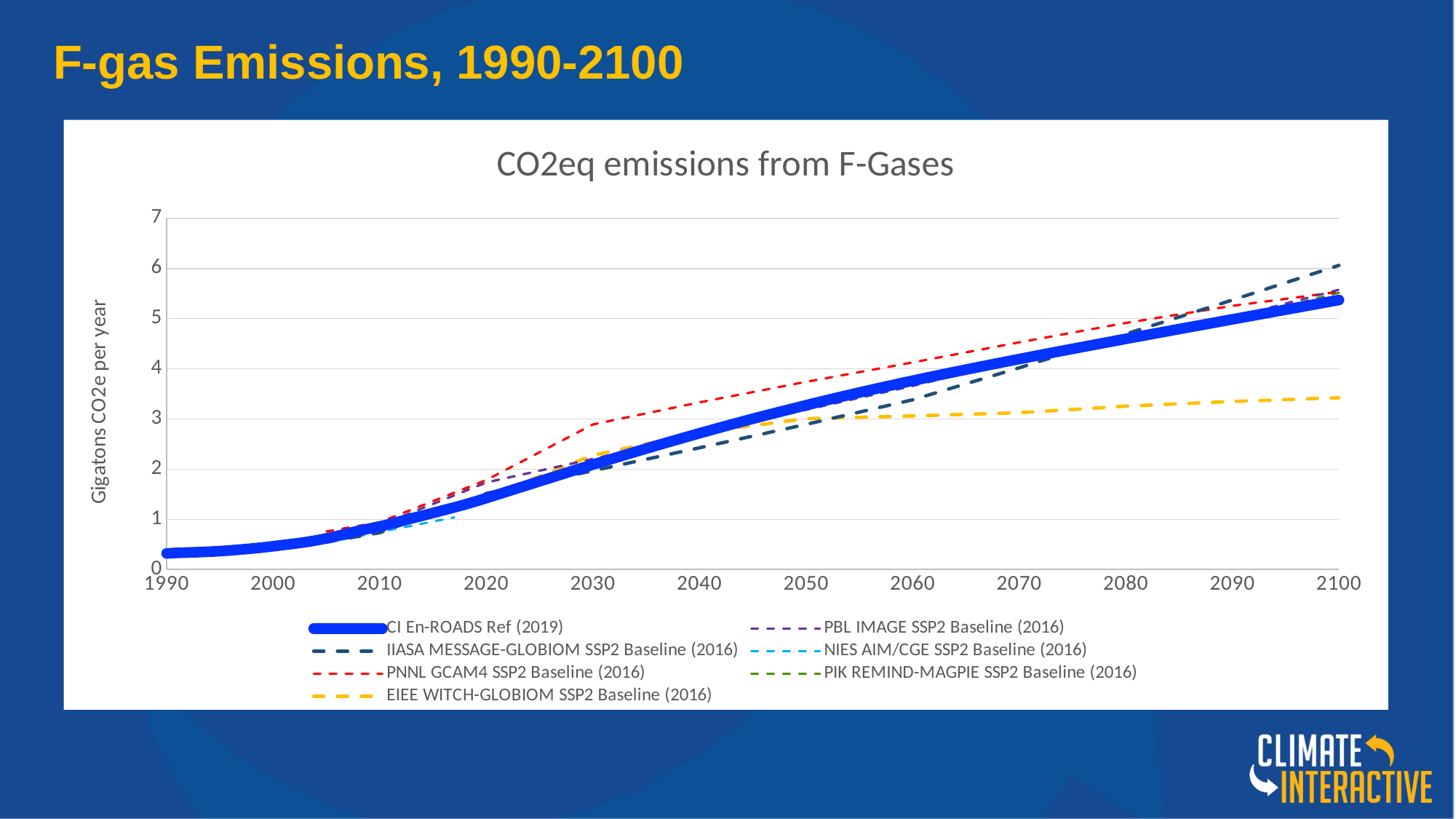
What is the title of the chart? CO2eq emissions from F-Gases What kind of chart is shown on the slide? line chart Does the CI En-ROADS Ref (2019) series rise or fall from 1990 to 2100? rise Which series has the lowest value at 2100? EIEE WITCH-GLOBIOM SSP2 Baseline (2016) At 2100, which is larger: IIASA MESSAGE-GLOBIOM SSP2 Baseline (2016) or EIEE WITCH-GLOBIOM SSP2 Baseline (2016)? IIASA MESSAGE-GLOBIOM SSP2 Baseline (2016) Is the value for EIEE WITCH-GLOBIOM SSP2 Baseline (2016) at 2100 greater or less than 4? less Is the value for CI En-ROADS Ref (2019) at 2100 greater or less than 5? greater Is the value for CI En-ROADS Ref (2019) at 1990 greater or less than 1? less Which series has the highest value at 2100? IIASA MESSAGE-GLOBIOM SSP2 Baseline (2016) What is the label on the vertical axis? Gigatons CO2e per year How many year labels are shown on the horizontal axis? 12 How many series does the legend list? 7